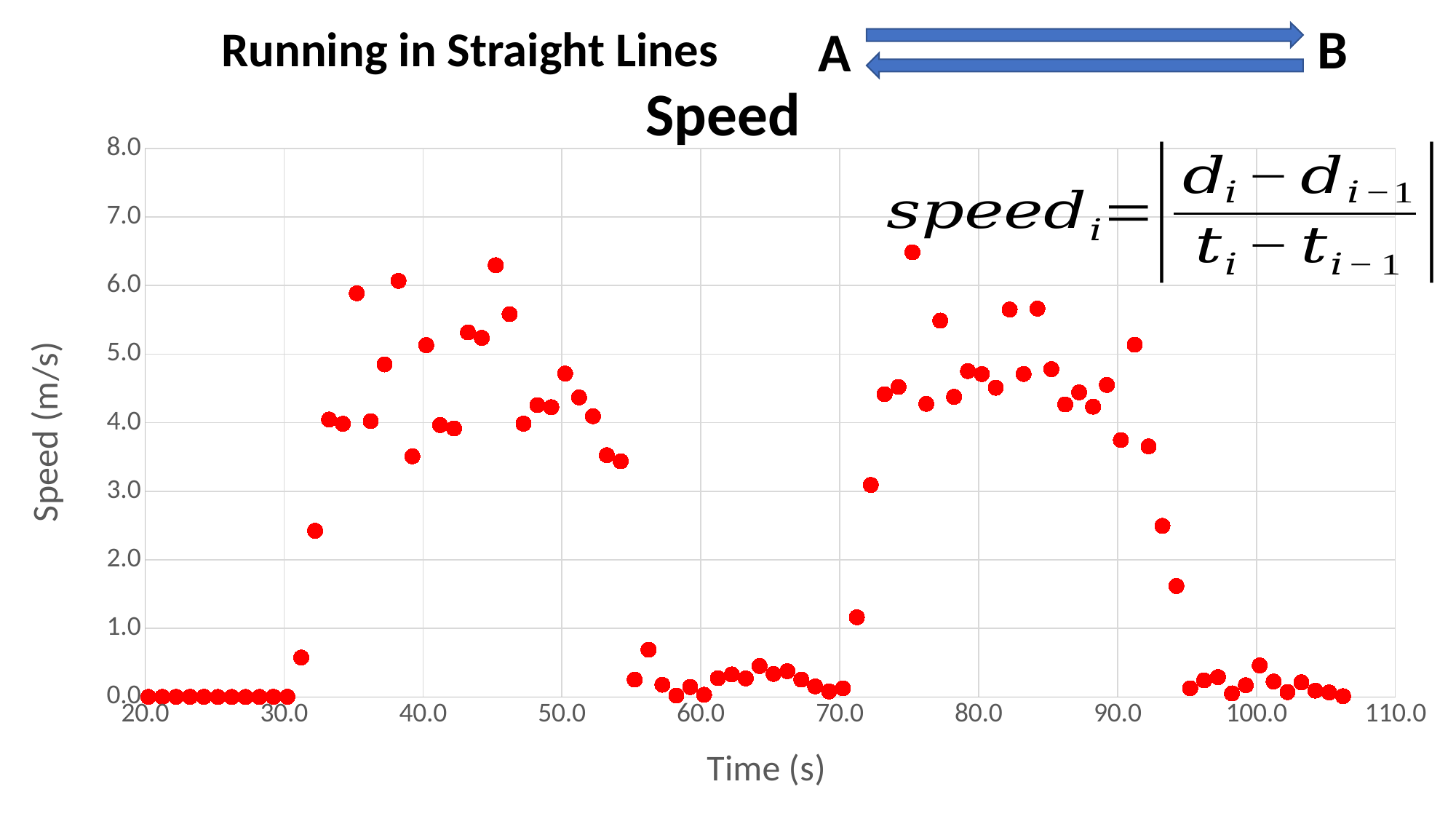
What is the label of the vertical axis of the chart? Speed (m/s) Which is larger, the speed at time 75.0 s or the speed at time 60.0 s? 75.0 s Is the speed at time 32.0 s greater or less than 3.0? less What is the title of the chart? Speed Which is larger, the speed at time 45.0 s or the speed at time 32.0 s? 45.0 s Is the speed at time 94.0 s greater or less than 2.0? less Is the speed at time 45.0 s greater or less than 6.0? greater What kind of chart is shown on the slide? scatter chart Between 90.0 s and 95.0 s, does the speed rise or fall? fall Between 30.0 s and 35.0 s, does the speed rise or fall? rise